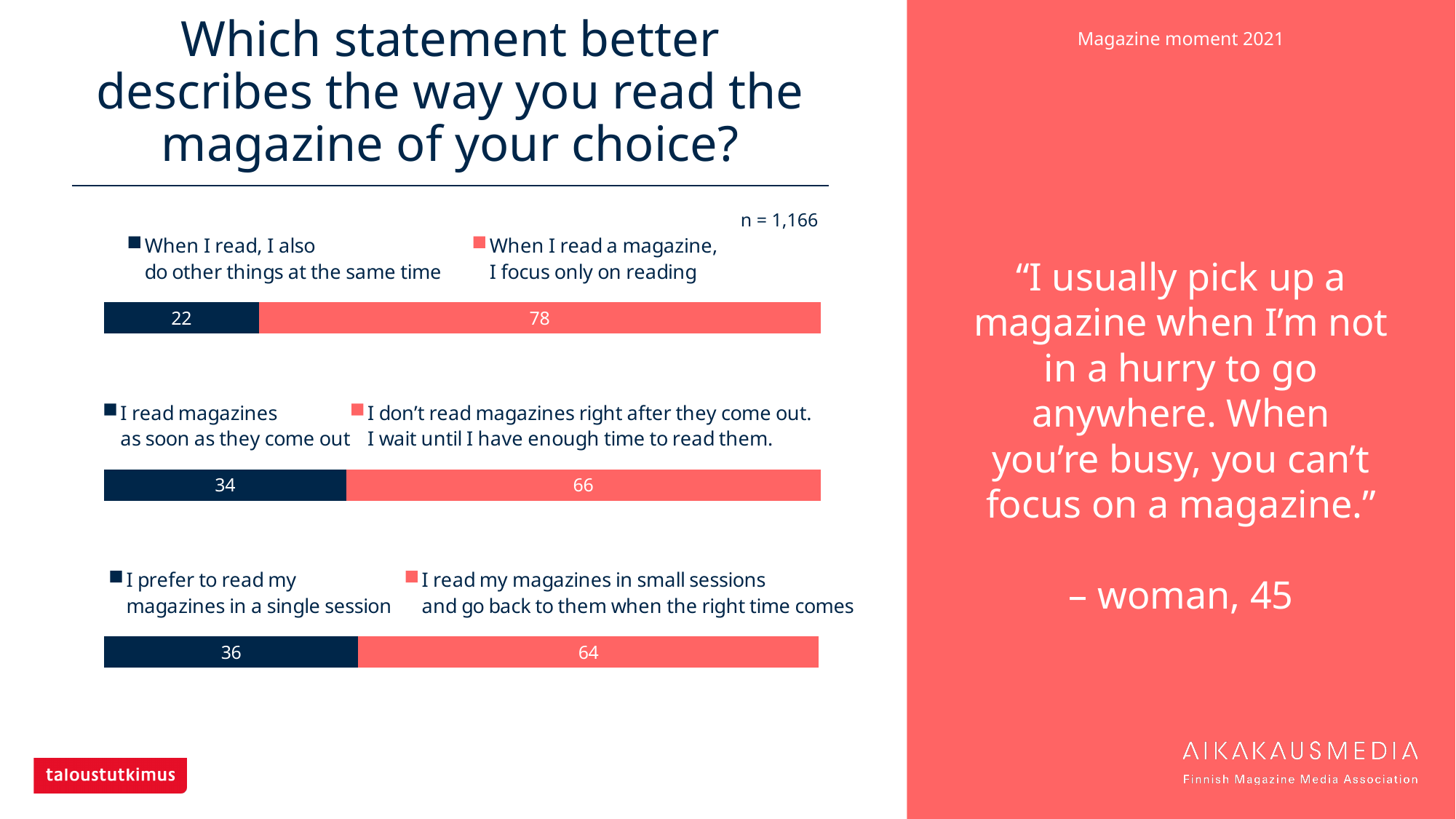
In the bottom chart, what is the value for "I prefer to read my magazines in a single session"? 36 In the top chart, what is the value for "When I read a magazine, I focus only on reading"? 78 In the bottom chart, what is the value for "I read my magazines in small sessions and go back to them when the right time comes"? 64 In the middle chart, what is the total of the two segments of the bar? 100 In the bottom chart, which statement has the larger value: "I prefer to read my magazines in a single session" or "I read my magazines in small sessions and go back to them when the right time comes"? I read my magazines in small sessions and go back to them when the right time comes In the middle chart, what is the value for "I read magazines as soon as they come out"? 34 How many series does the legend of the top chart list? 2 What sample size (n) is shown on the slide? n = 1,166 In the top chart, what is the value for "When I read, I also do other things at the same time"? 22 In the middle chart, what is the value for "I don't read magazines right after they come out. I wait until I have enough time to read them."? 66 In the top chart, what is the difference between the two values? 56 What kind of chart is used on this slide? Bar chart